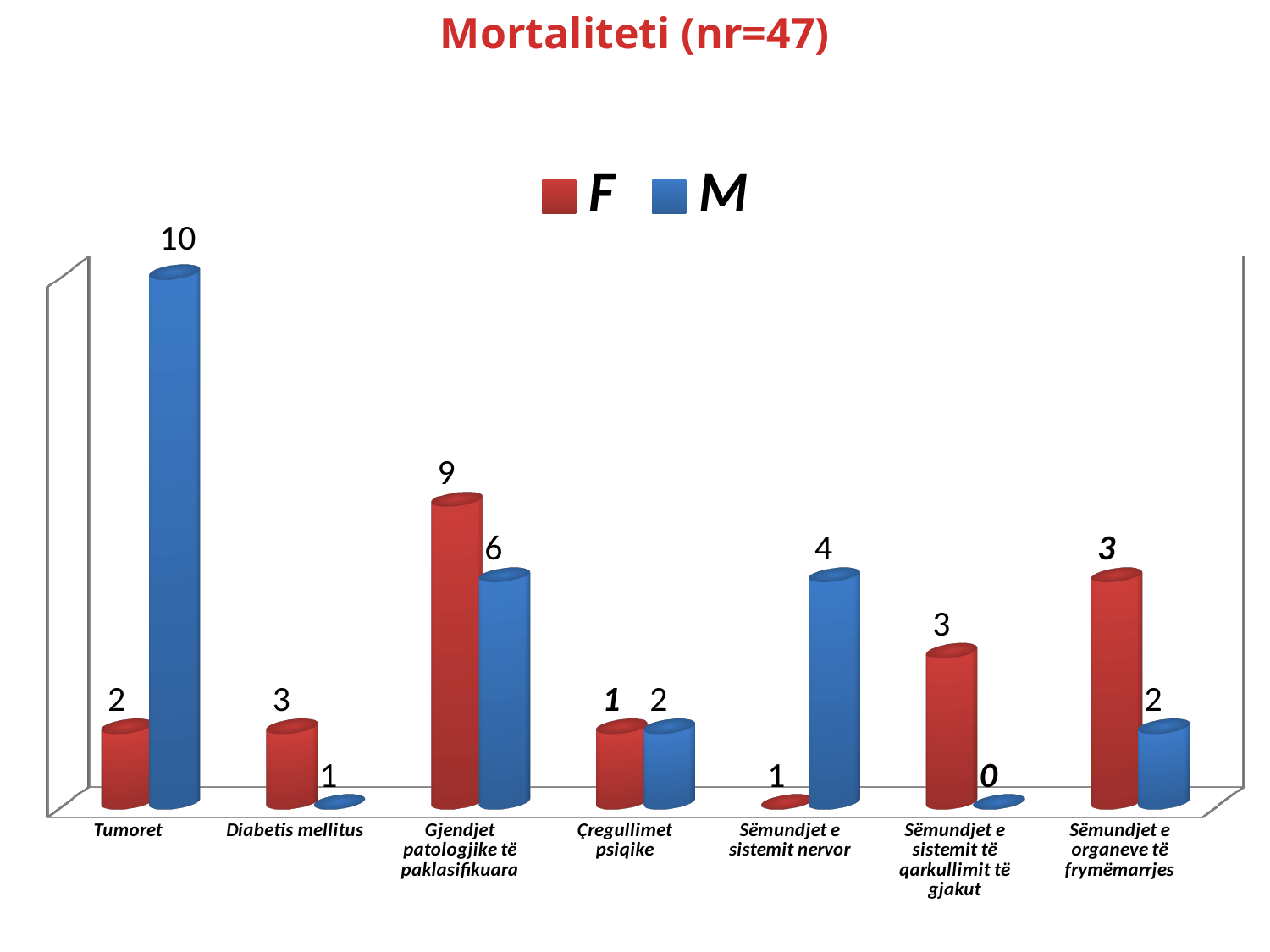
Which is larger in the Sëmundjet e sistemit nervor category, F or M? M What is the value for M in the Tumoret category? 10 What is the value for M in the Sëmundjet e sistemit të qarkullimit të gjakut category? 0 What is the difference between the M and F values for Tumoret? 8 Which category has the highest M value? Tumoret How many series does the legend list? 2 What is the value for F in the Diabetis mellitus category? 3 What is the value for F in the Gjendjet patologjike të paklasifikuara category? 9 What is the title of the chart? Mortaliteti (nr=47) How many categories are shown on the x axis? 7 What kind of chart is shown on the slide? Bar chart